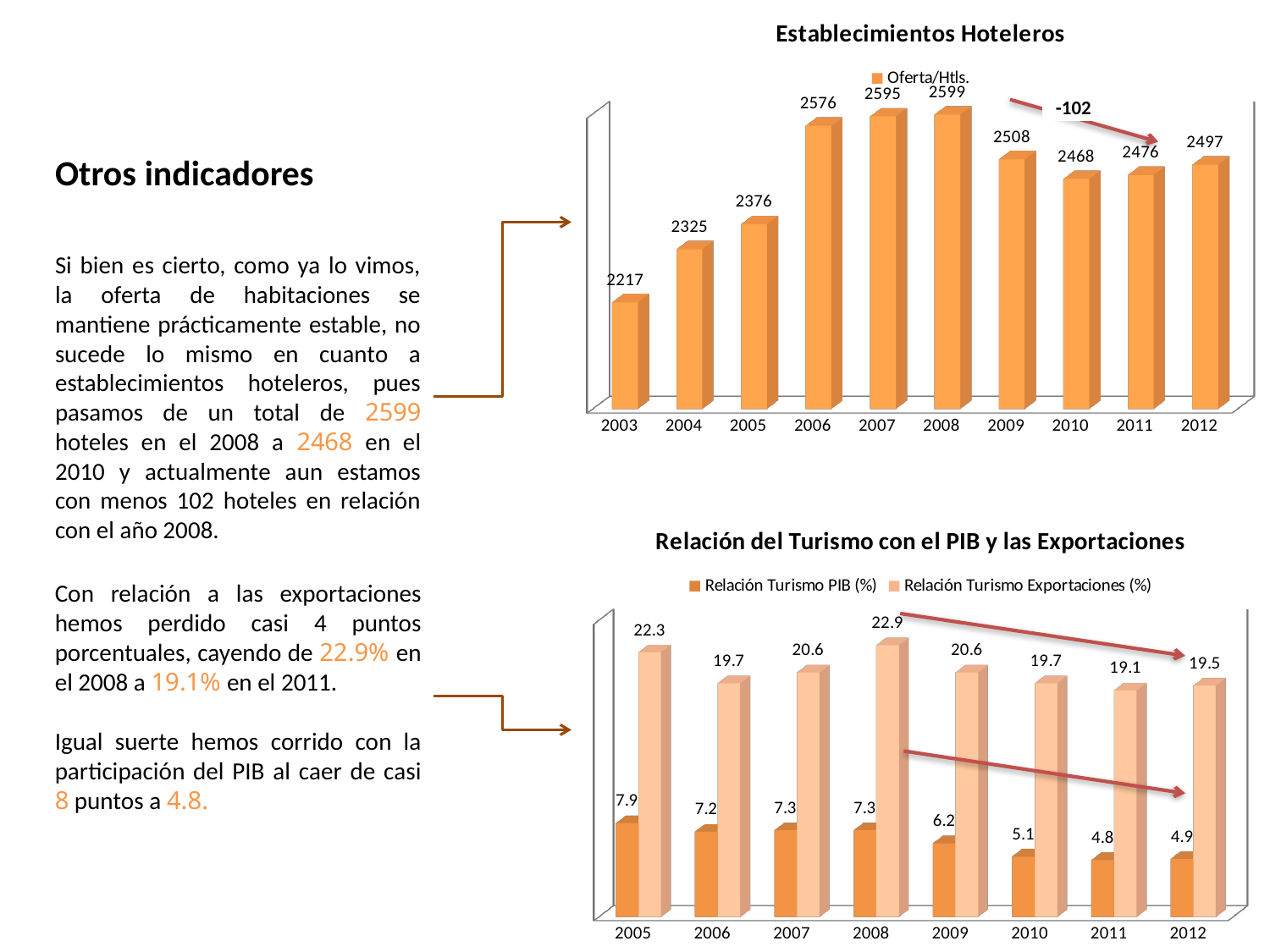
In the 'Relación del Turismo con el PIB y las Exportaciones' chart, which year has the lowest Relación Turismo PIB (%) value? 2011 In the 'Establecimientos Hoteleros' chart, how many years are shown on the x axis? 10 In the 'Relación del Turismo con el PIB y las Exportaciones' chart, what is the value of Relación Turismo Exportaciones (%) for 2008? 22.9 In the 'Relación del Turismo con el PIB y las Exportaciones' chart, does the Relación Turismo PIB (%) series generally rise or fall from 2005 to 2012? fall In the 'Establecimientos Hoteleros' chart, which year has the highest value? 2008 In the 'Establecimientos Hoteleros' chart, what is the value for 2008? 2599 In the 'Relación del Turismo con el PIB y las Exportaciones' chart, what is the value of Relación Turismo PIB (%) for 2011? 4.8 In the 'Establecimientos Hoteleros' chart, what kind of chart is it? bar chart In the 'Relación del Turismo con el PIB y las Exportaciones' chart, is the Relación Turismo Exportaciones (%) value for 2005 larger or smaller than the value for 2012? larger In the 'Relación del Turismo con el PIB y las Exportaciones' chart, how many series does the legend list? 2 In the 'Establecimientos Hoteleros' chart, which year has the lowest value? 2003 In the 'Establecimientos Hoteleros' chart, what is the difference between the 2008 and 2010 values? 131